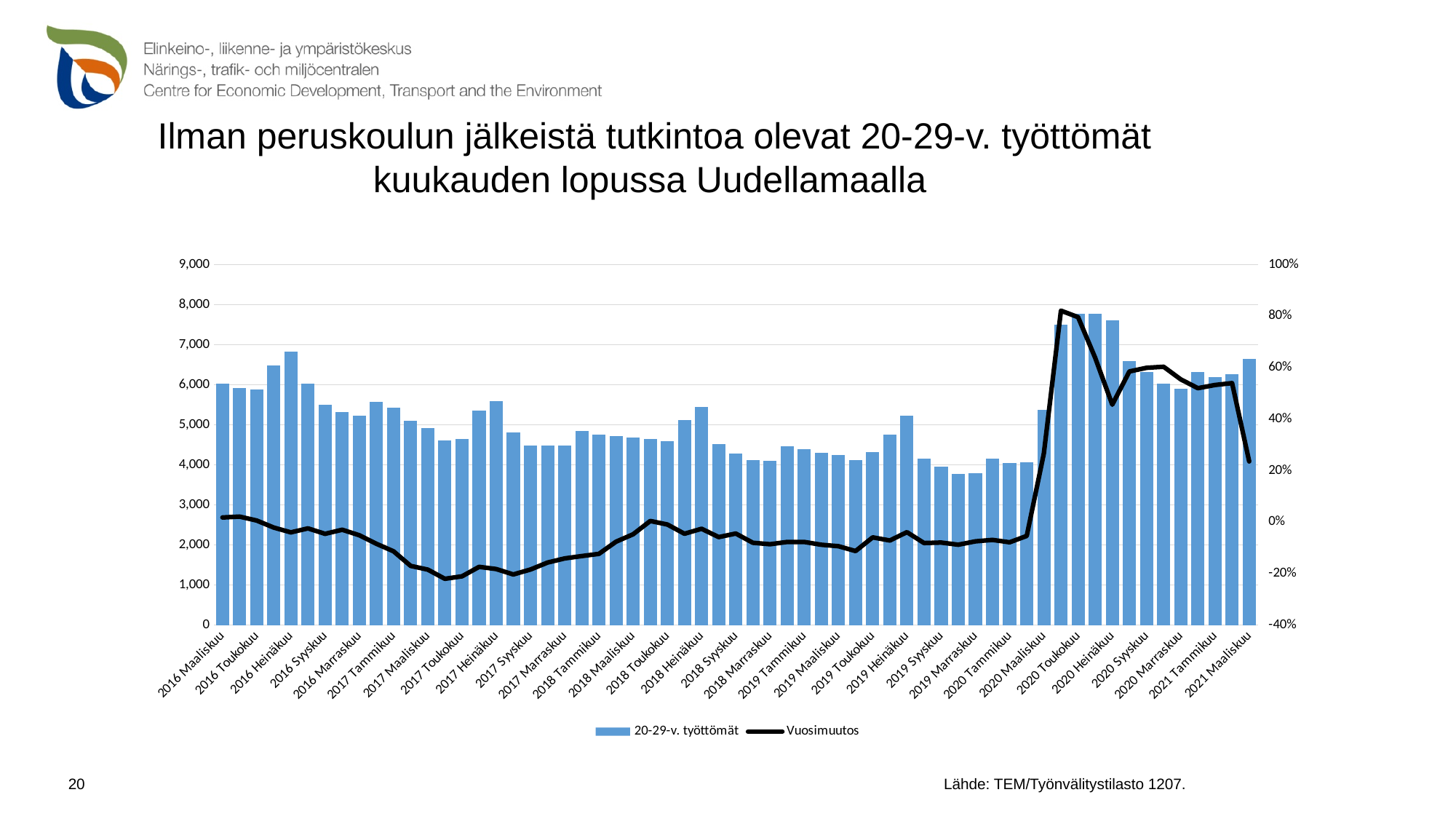
In which year does the Vuosimuutos line reach its peak? 2020 What are the two series named in the legend? 20-29-v. työttömät and Vuosimuutos Is the number of 20-29-v. työttömät in 2019 Marraskuu greater or less than 4,000? less What is the highest value shown on the right-hand percentage axis? 100% Is the number of 20-29-v. työttömät in 2020 Toukokuu greater or less than 7,000? greater How many series does the legend list? 2 Is the number of 20-29-v. työttömät in 2016 Heinäkuu greater or less than 6,000? greater What kind of chart is shown on the slide? A bar chart combined with a line Do the 20-29-v. työttömät bars rise or fall from 2020 Tammikuu to 2020 Toukokuu? rise Which has more 20-29-v. työttömät, 2016 Heinäkuu or 2019 Marraskuu? 2016 Heinäkuu